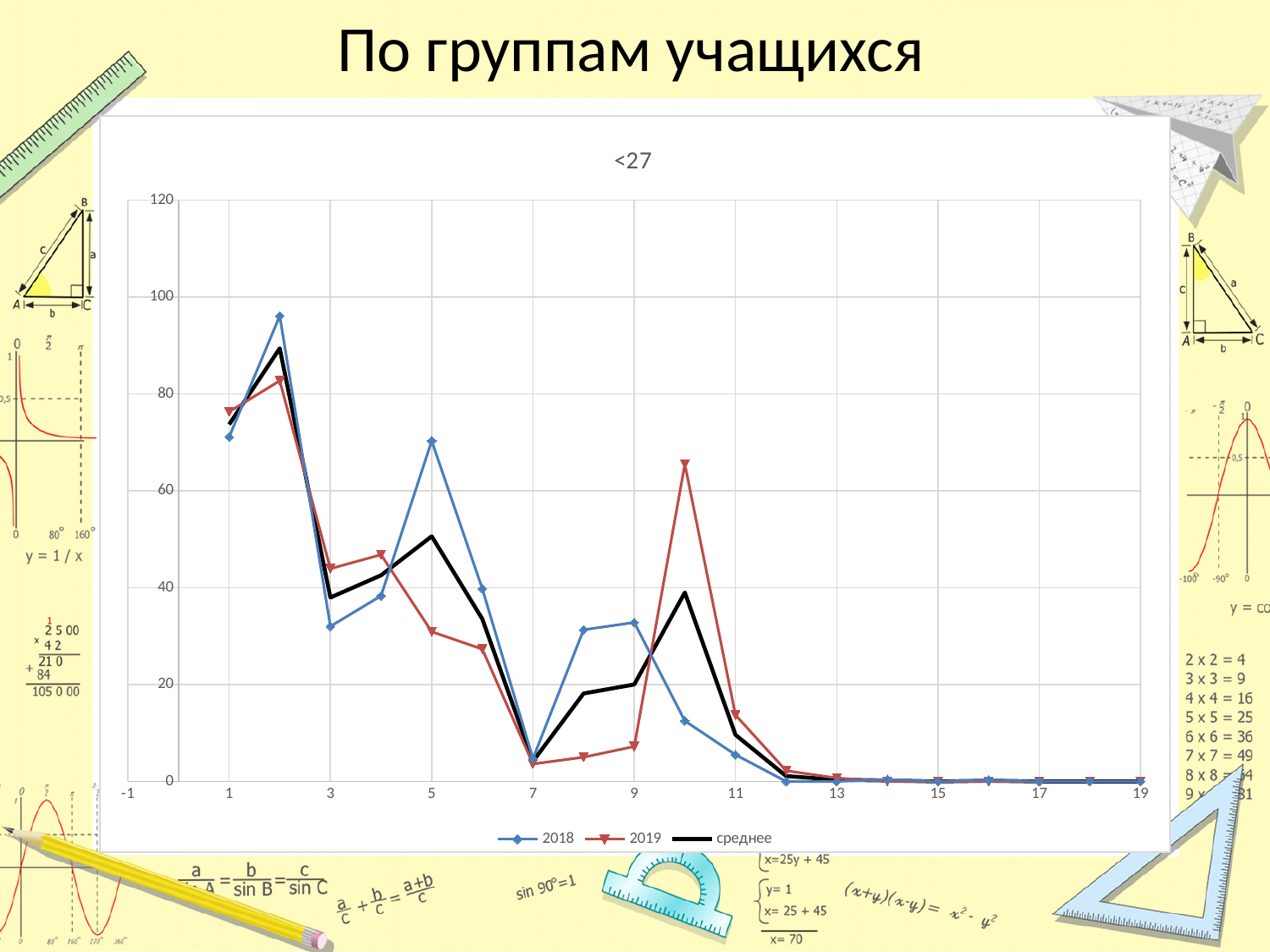
How many series does the legend list? 3 At which x value does the 2019 series reach its highest point? 2 Is the value for 2019 at x=10 greater or less than 60? greater At x=5, which series has the larger value, 2018 or 2019? 2018 Is the value for 2018 at x=2 greater or less than 80? greater Which series are listed in the legend? 2018, 2019, среднее At x=10, which series has the larger value, 2018 or 2019? 2019 Is the value for 2018 at x=3 greater or less than 40? less What type of chart is shown on the slide? line chart Do the values of the среднее series rise or fall from x=2 to x=3? fall What is the title of the chart? <27 At which x value does the 2018 series reach its highest point? 2